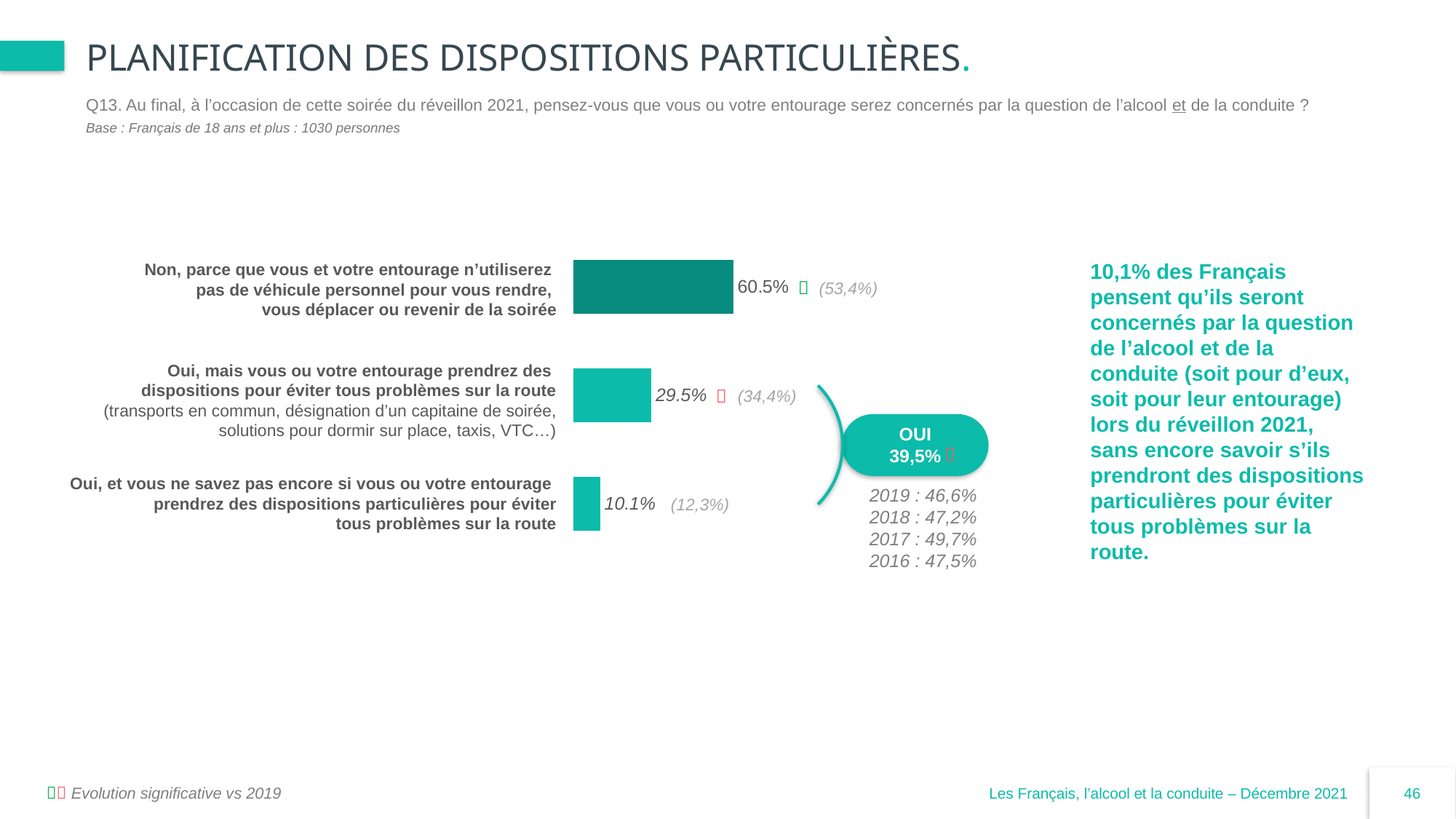
What is the value for "Non, parce que vous et votre entourage n'utiliserez pas de véhicule personnel pour vous rendre, vous déplacer ou revenir de la soirée"? 60.5% Which is larger: the value for "Oui, mais vous ou votre entourage prendrez des dispositions..." or the value for "Oui, et vous ne savez pas encore..."? Oui, mais vous ou votre entourage prendrez des dispositions pour éviter tous problèmes sur la route What is the difference between the value for "Non, parce que vous et votre entourage n'utiliserez pas de véhicule personnel..." (60.5%) and the value for "Oui, mais vous ou votre entourage prendrez des dispositions..." (29.5%)? 31 percentage points What was the previous value (shown in parentheses) for "Non, parce que vous et votre entourage n'utiliserez pas de véhicule personnel..."? 53,4% What is the combined "OUI" percentage shown in the rounded box on the chart? 39,5% Which category has the lowest value? Oui, et vous ne savez pas encore si vous ou votre entourage prendrez des dispositions particulières pour éviter tous problèmes sur la route What was the "OUI" percentage in 2019 according to the chart? 46,6% How many categories (bars) does the chart show? 3 Which category has the highest value? Non, parce que vous et votre entourage n'utiliserez pas de véhicule personnel pour vous rendre, vous déplacer ou revenir de la soirée What kind of chart is shown on the slide? Bar chart What is the value for "Oui, et vous ne savez pas encore si vous ou votre entourage prendrez des dispositions particulières pour éviter tous problèmes sur la route"? 10.1% What is the value for "Oui, mais vous ou votre entourage prendrez des dispositions pour éviter tous problèmes sur la route"? 29.5%